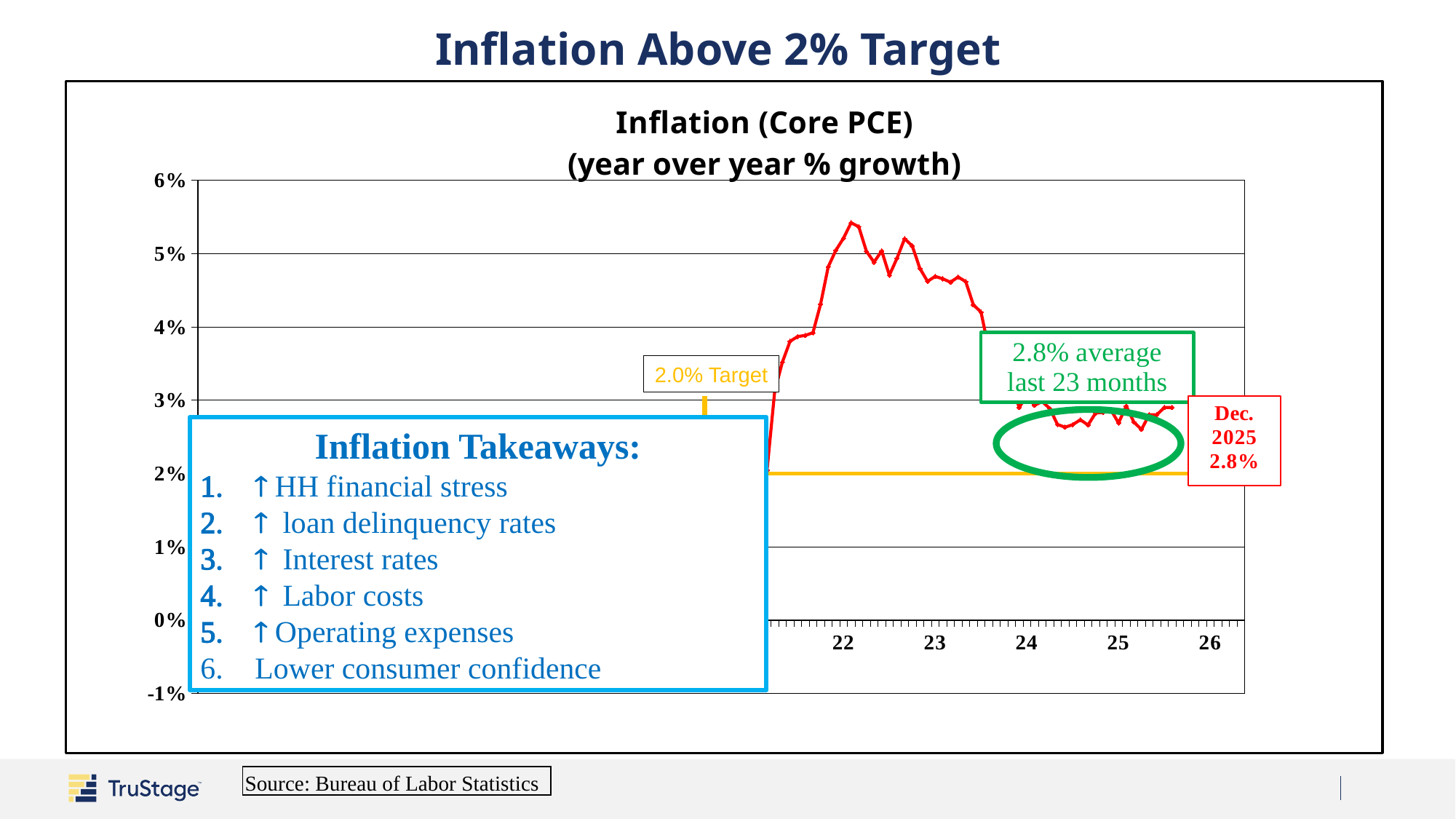
Is the inflation value in 2025 greater or less than 4%? less Does the inflation line rise or fall from its 2022 peak to 2024? fall What is the source cited for the chart data? Bureau of Labor Statistics What kind of chart is shown on the slide? line chart What is the Core PCE inflation value labeled for Dec. 2025? 2.8% How many year labels are shown on the x axis? 5 Which is larger, the Dec. 2025 inflation value or the 2.0% target? Dec. 2025 inflation value What is the title of the chart? Inflation (Core PCE) (year over year % growth) What inflation target is marked on the chart? 2.0% What average inflation over the last 23 months is annotated on the chart? 2.8% By how much does the Dec. 2025 inflation value of 2.8% exceed the 2.0% target? 0.8% Is the peak of the inflation line in 2022 greater or less than 5%? greater